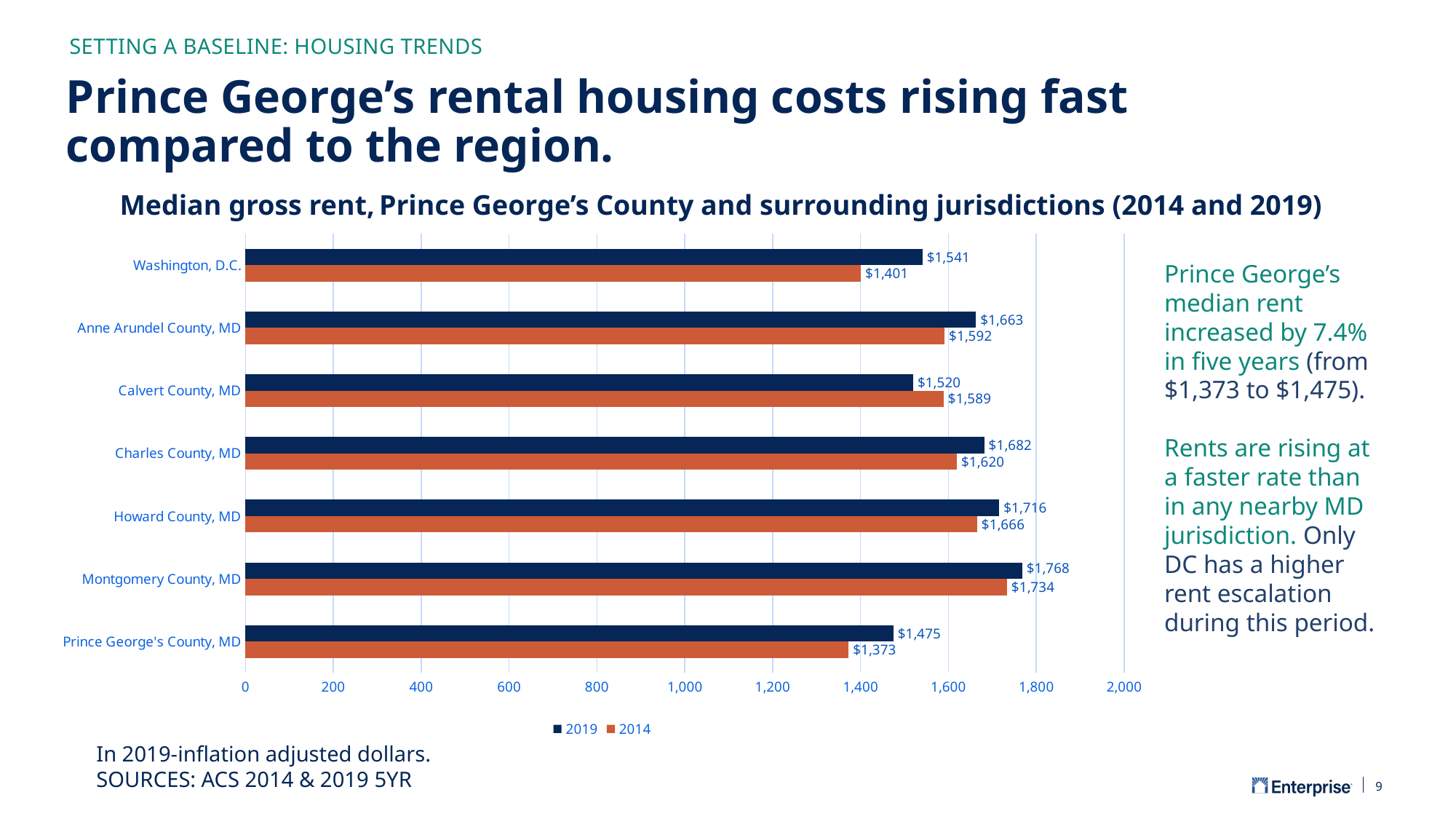
What kind of chart is shown on the slide? Bar chart Which jurisdiction had the highest median gross rent in 2019? Montgomery County, MD What was the median gross rent in Prince George's County, MD in 2019? $1,475 How many jurisdictions are shown in the chart? 7 What is the difference between the 2019 median gross rent in Montgomery County, MD and Howard County, MD? $52 What was the median gross rent in Washington, D.C. in 2014? $1,401 What was the median gross rent in Calvert County, MD in 2014? $1,589 What is the difference between the 2019 and 2014 median gross rent for Prince George's County, MD? $102 Which colour represents the 2014 series in the chart? Orange How many series does the legend list? 2 Which was higher for Calvert County, MD: the 2014 or the 2019 median gross rent? 2014 Which jurisdiction had the lowest median gross rent in 2014? Prince George's County, MD